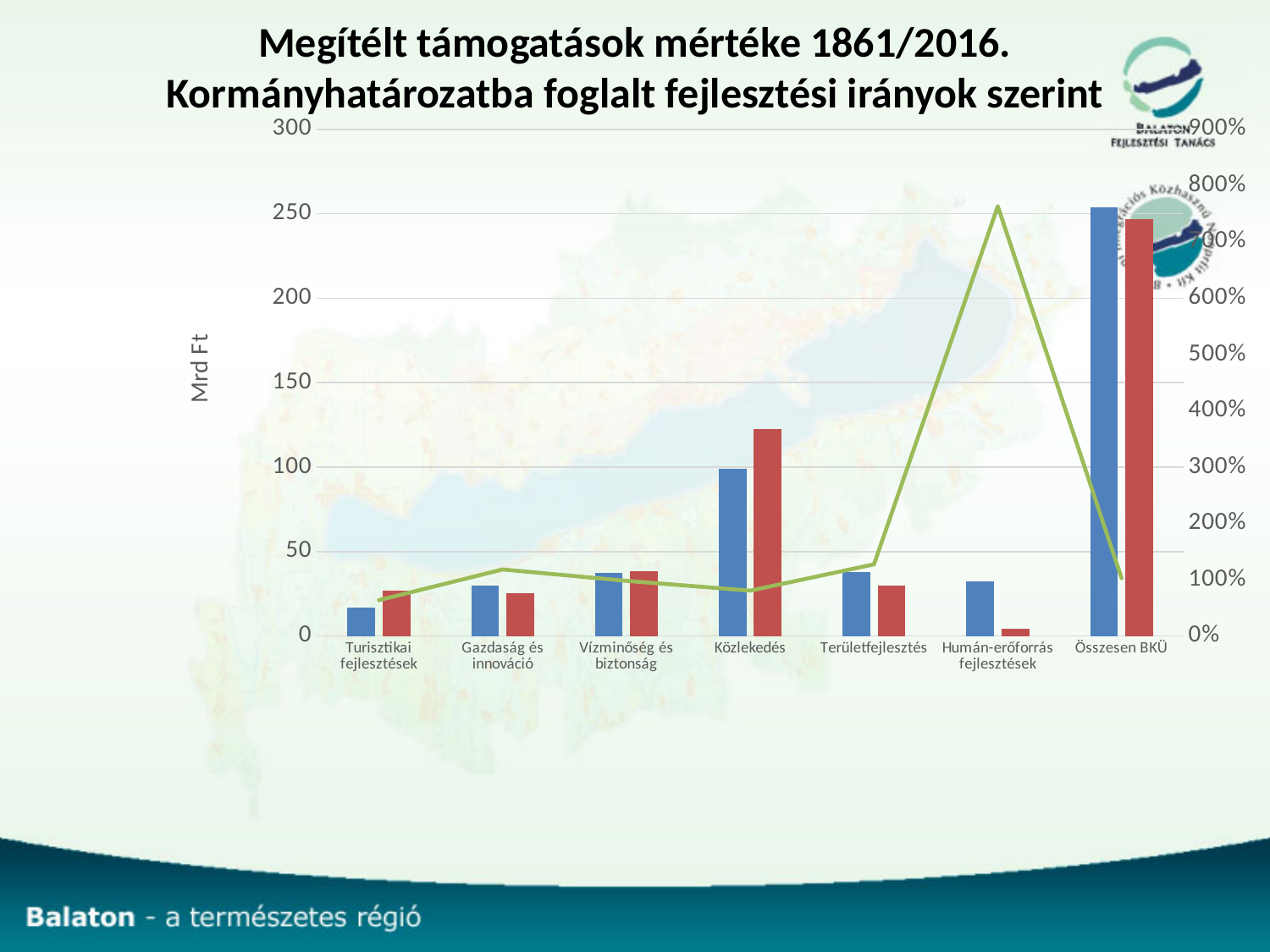
At which category does the green line reach its highest point? Humán-erőforrás fejlesztések What kind of chart is shown on the slide? A bar chart combined with a line Which category has the shortest red bar? Humán-erőforrás fejlesztések For Humán-erőforrás fejlesztések, which bar is taller, the blue one or the red one? The blue one Is the green line value for Humán-erőforrás fejlesztések greater or less than 700%? greater What is the label of the left vertical axis? Mrd Ft For Közlekedés, which bar is taller, the blue one or the red one? The red one Which category has the tallest blue bar? Összesen BKÜ Is the blue bar for Turisztikai fejlesztések greater or less than 50 Mrd Ft? less Which category has the shortest blue bar? Turisztikai fejlesztések Is the red bar for Közlekedés greater or less than 100 Mrd Ft? greater How many categories are shown on the x axis of the chart? 7